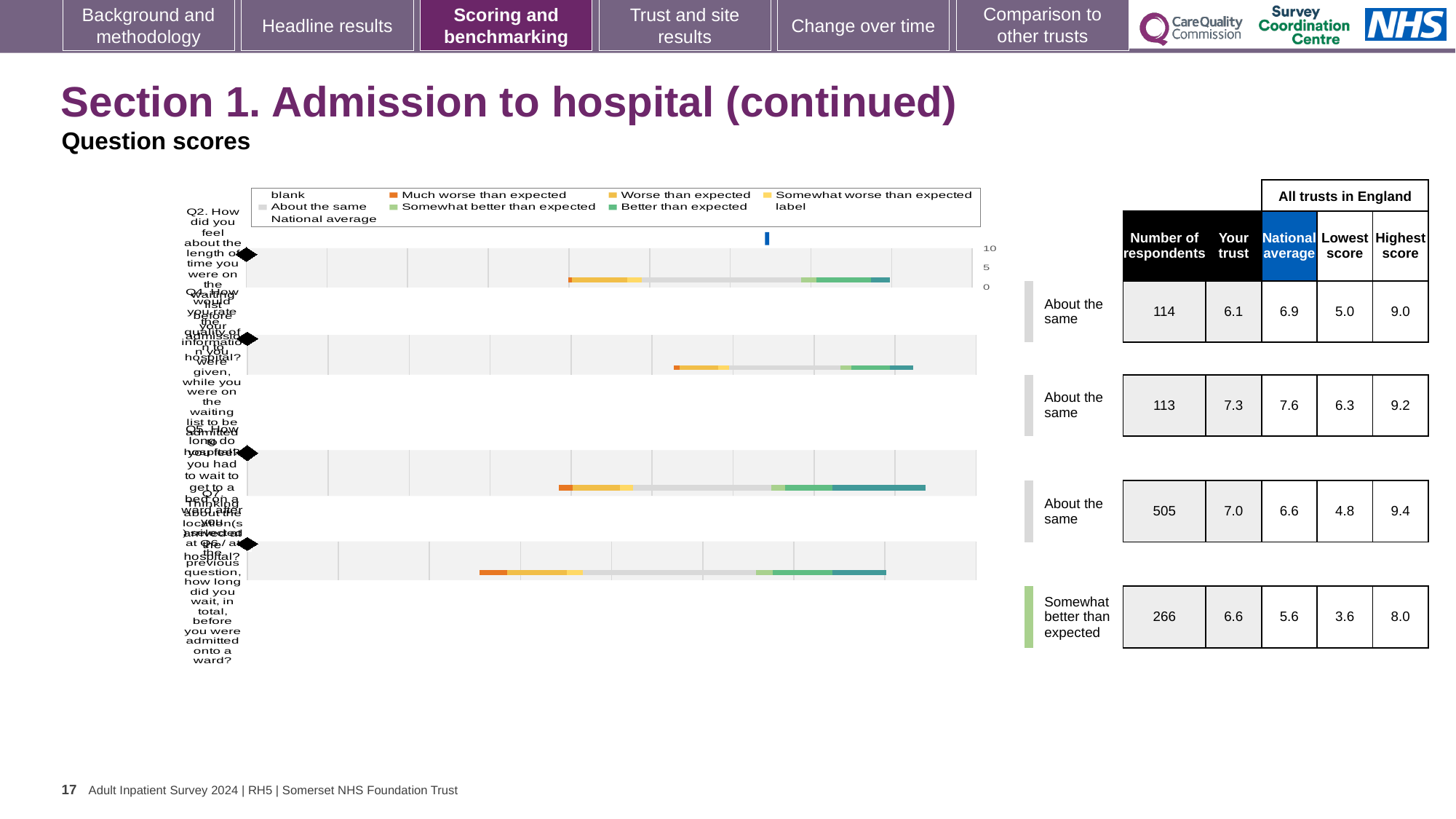
In the table, what is the national average for the fourth row? 5.6 In the table, what is the highest score for the third row? 9.4 In the chart legend, what colour represents 'Much worse than expected'? orange In the chart legend, what colour represents 'Better than expected'? teal green Which row of the table has the lowest 'Lowest score'? the fourth row (3.6) What kind of chart is shown on the left of the slide? bar chart Which row of the table has the largest number of respondents? the third row (505) In the table, what is the 'Your trust' score for the second row? 7.3 In the fourth row of the table, what is the difference between the 'Your trust' score and the national average? 1.0 How many question rows (bars) are plotted in the chart? 4 In the first row of the table, is the 'Your trust' score or the national average larger? national average In the table, what is the number of respondents for the first row? 114